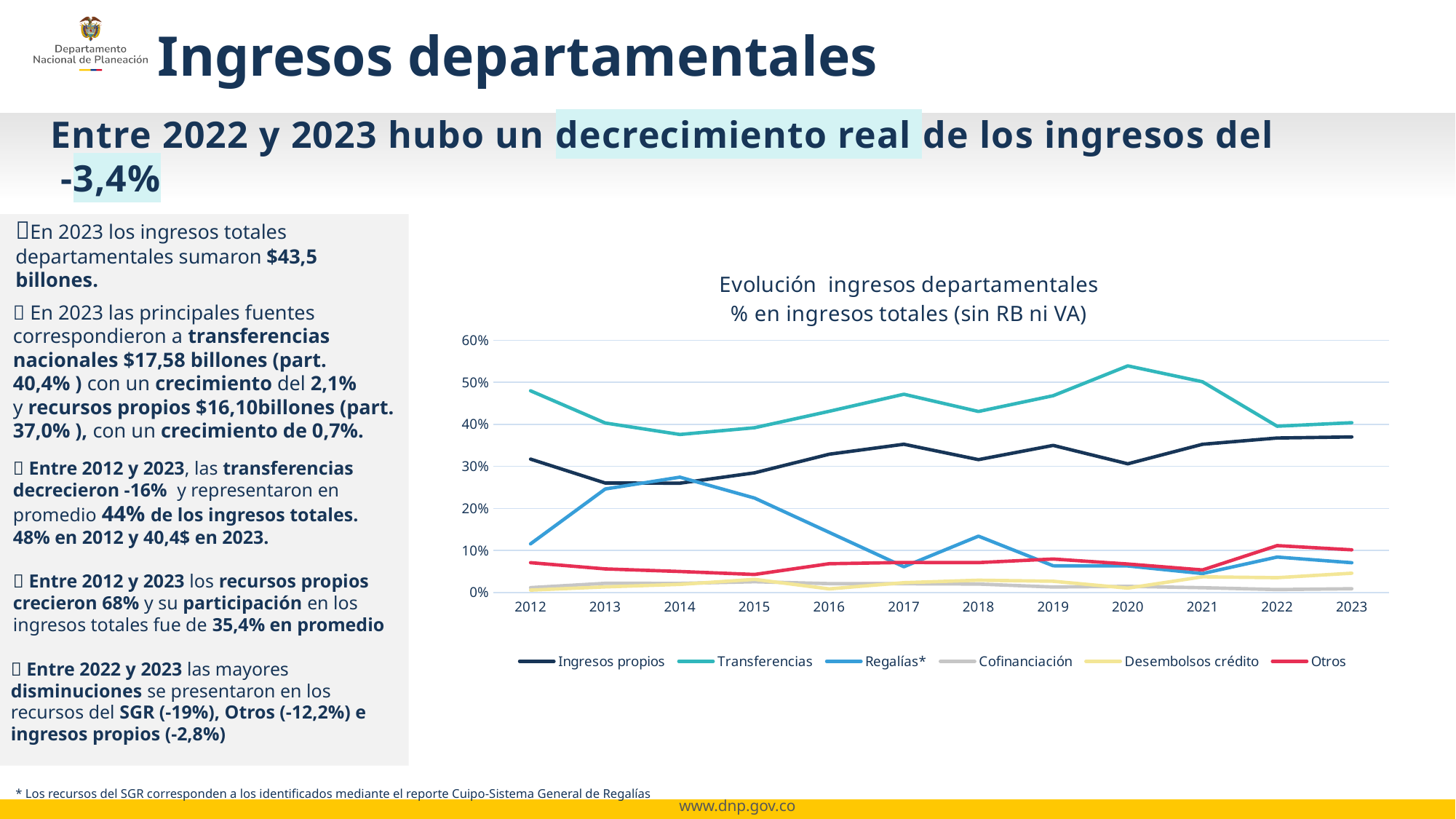
Is the value for Transferencias in 2020 greater or less than 50%? greater What is the title of the chart? Evolución ingresos departamentales % en ingresos totales (sin RB ni VA) How many years are shown along the x axis of the chart? 12 How many series does the legend of the chart list? 6 What kind of chart is shown on the slide? line chart Which series has the lowest value in 2023? Cofinanciación Does the Regalías* series rise or fall between 2014 and 2017? fall Which series has the highest value in 2012? Transferencias In which year does the Transferencias series reach its highest value? 2020 In 2023, which is larger: Transferencias or Ingresos propios? Transferencias Is the value for Ingresos propios in 2023 greater or less than 40%? less Is the value for Regalías* in 2017 greater or less than 10%? less